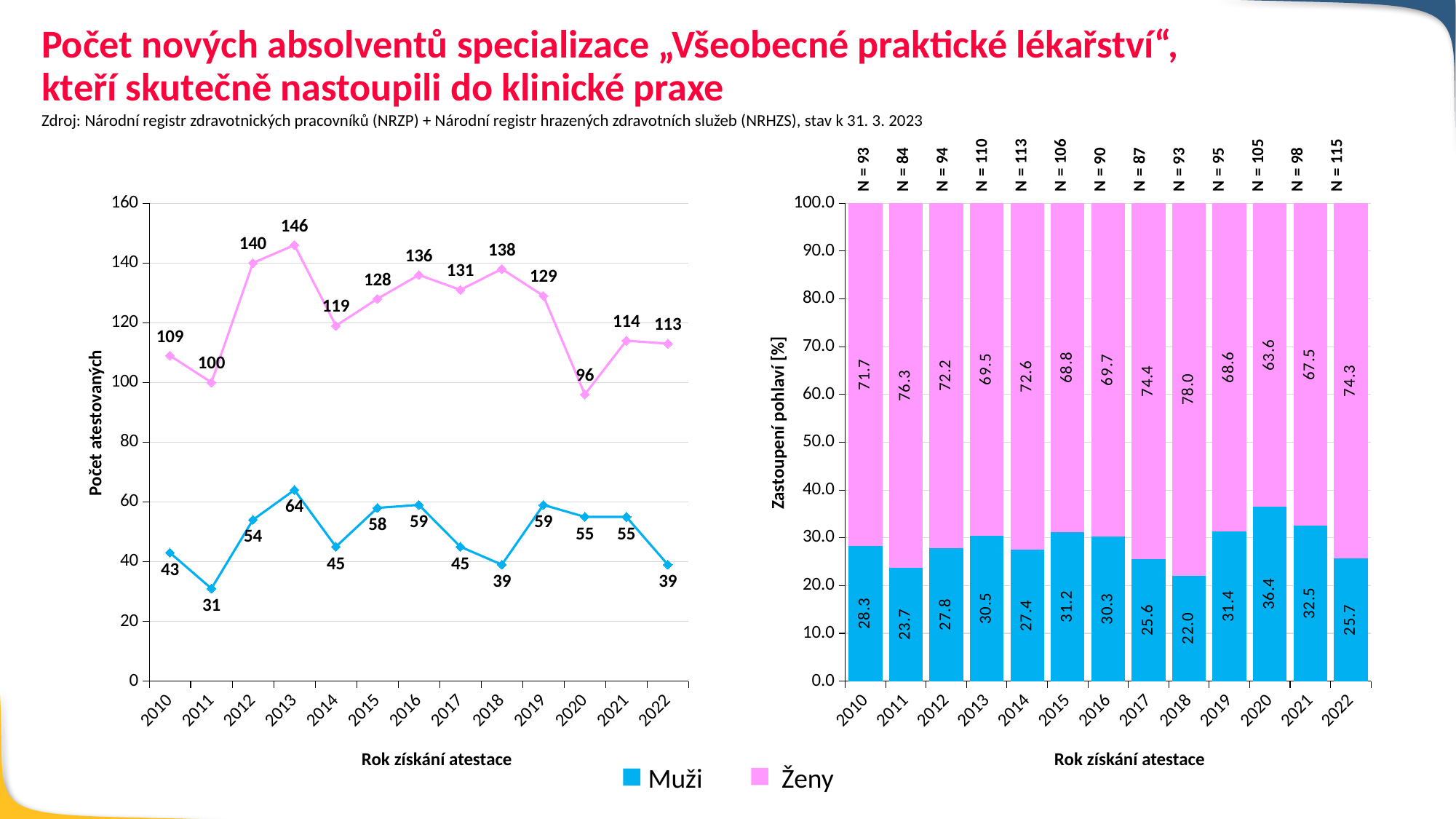
In the left line chart, what is the difference between the Ženy and Muži values in 2020? 41 In the left line chart, what is the value for Ženy in 2013? 146 In the right stacked bar chart, what is the Muži share in 2020? 36.4 What type of chart is the chart on the right? stacked bar chart What type of chart is the chart on the left? line chart In the right stacked bar chart, what is the Ženy share in 2018? 78.0 How many series does the legend list? 2 In the right stacked bar chart, in which year is the Muži share highest? 2020 In the left line chart, in which year is the Ženy series highest? 2013 In the left line chart, in which year is the Muži series lowest? 2011 In the left line chart, which is larger: the Muži value in 2013 or the Muži value in 2016? 2013 In the left line chart, what is the value for Muži in 2011? 31